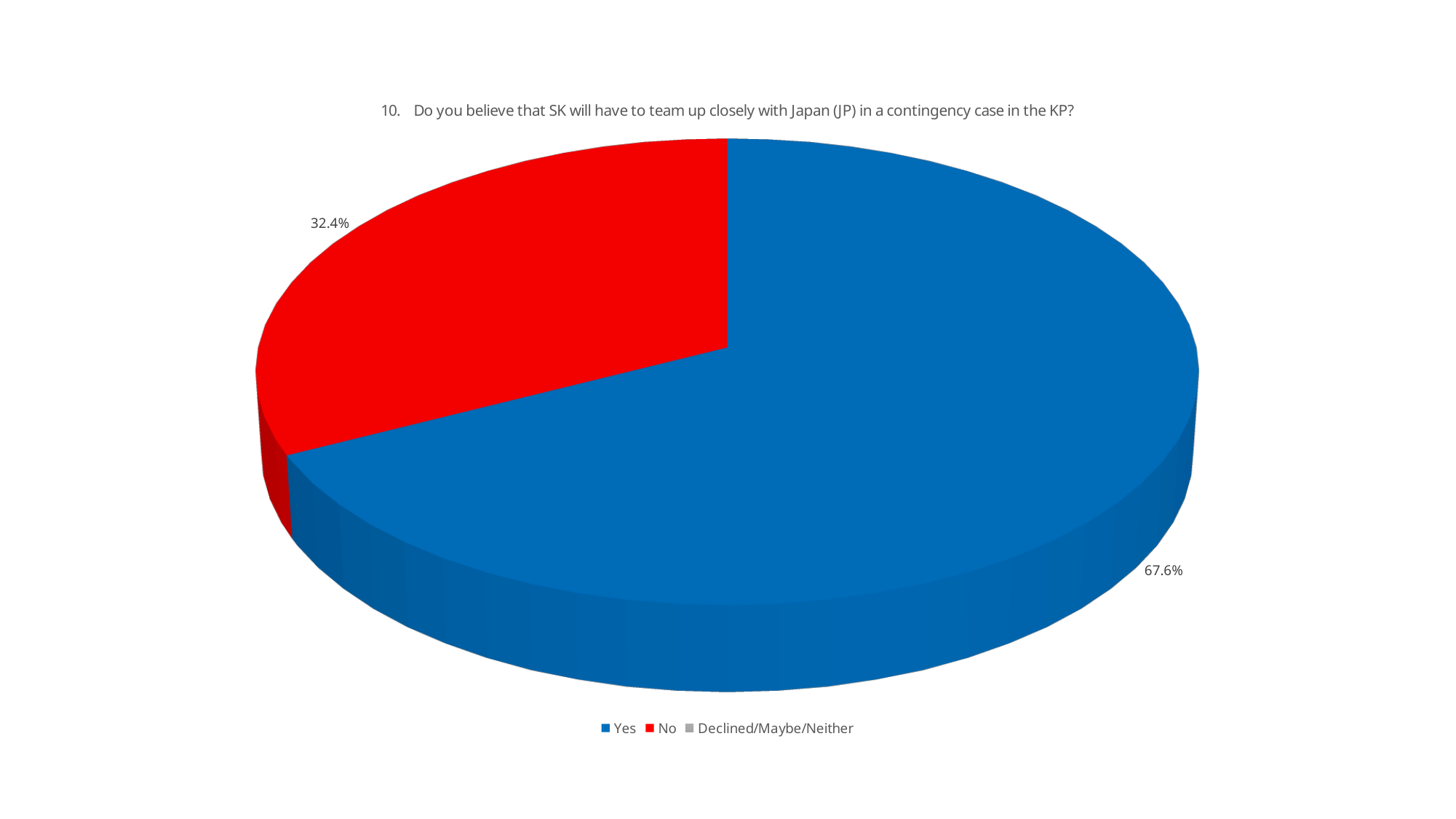
Which of the two visible slices is larger, "Yes" or "No"? Yes What is the difference in percentage points between the "Yes" and "No" slices? 35.2 What kind of chart is shown on the slide? pie chart Which response has the largest slice of the pie? Yes What share of the pie does the "Yes" slice represent? 67.6% What colour is the "No" slice? red What is the title of the chart? 10. Do you believe that SK will have to team up closely with Japan (JP) in a contingency case in the KP? What share of the pie does the "No" slice represent? 32.4% How many entries does the legend list? 3 Is the share for "Yes" greater or less than 50%? greater